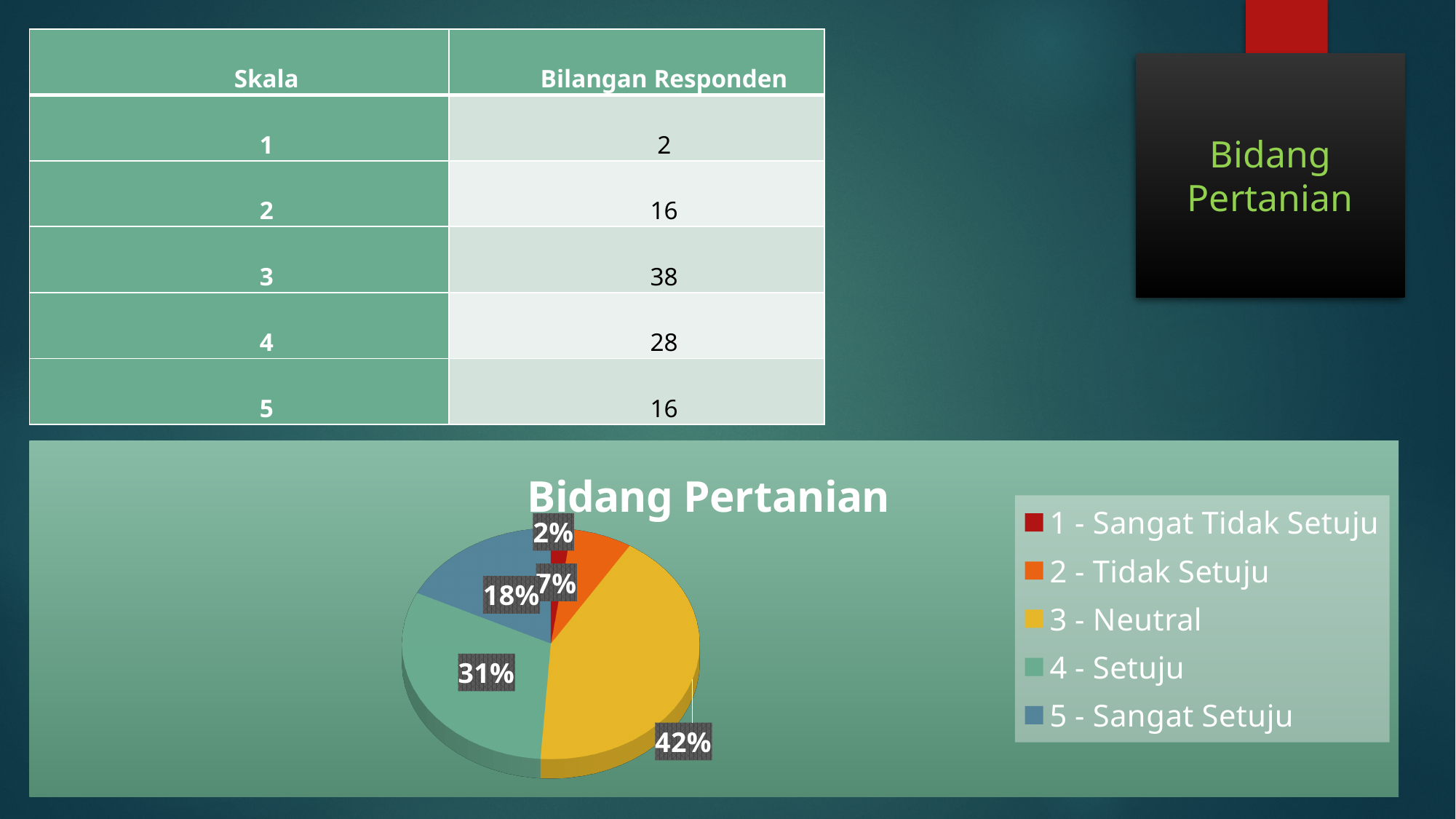
How many entries does the chart legend list? 5 What is the title of the chart? Bidang Pertanian Which category has the smallest share of the pie? 1 - Sangat Tidak Setuju What type of chart is shown on the slide? Pie chart What percentage is shown for the '4 - Setuju' slice? 31% What percentage is shown for the '3 - Neutral' slice? 42% What is the difference in percentage points between the '3 - Neutral' slice and the '4 - Setuju' slice? 11 What percentage is shown for the '1 - Sangat Tidak Setuju' slice? 2% How many slices does the pie chart have? 5 Which category has the largest share of the pie? 3 - Neutral Which slice is larger: '2 - Tidak Setuju' or '5 - Sangat Setuju'? 5 - Sangat Setuju What percentage is shown for the '5 - Sangat Setuju' slice? 18%